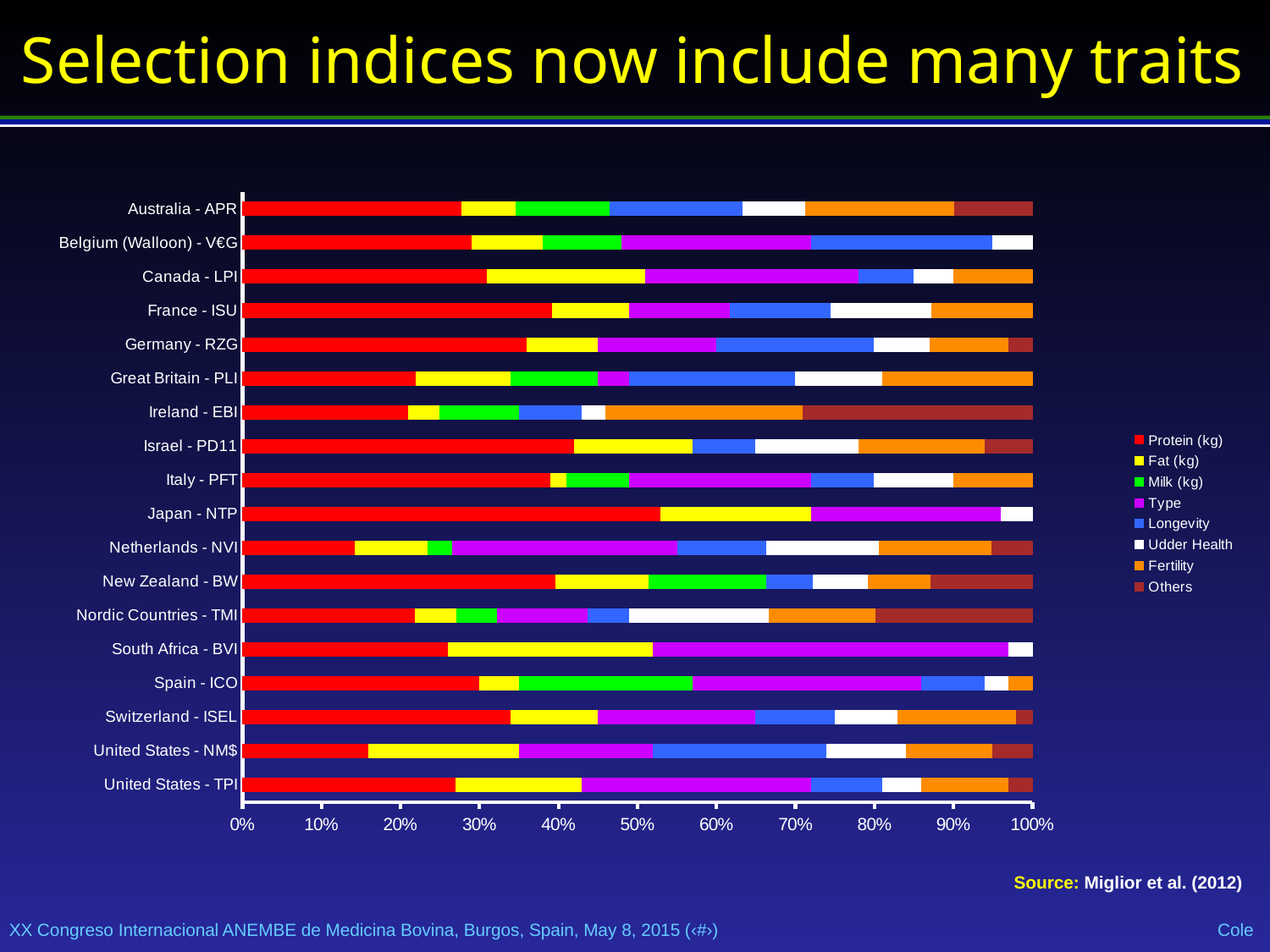
How many selection indices (categories) are plotted on the chart? 18 How many series does the legend list? 8 What kind of chart is shown on the slide? stacked bar chart Which index has the largest Longevity segment? Belgium (Walloon) - V€G Is the Protein (kg) share for Japan - NTP greater or less than 40%? greater Which index has the largest Milk (kg) segment? Spain - ICO Which index has the largest Protein (kg) segment? Japan - NTP What is the title of the slide containing the chart? Selection indices now include many traits Which trait is listed first in the legend? Protein (kg) Is the Protein (kg) share for Netherlands - NVI greater or less than 20%? less